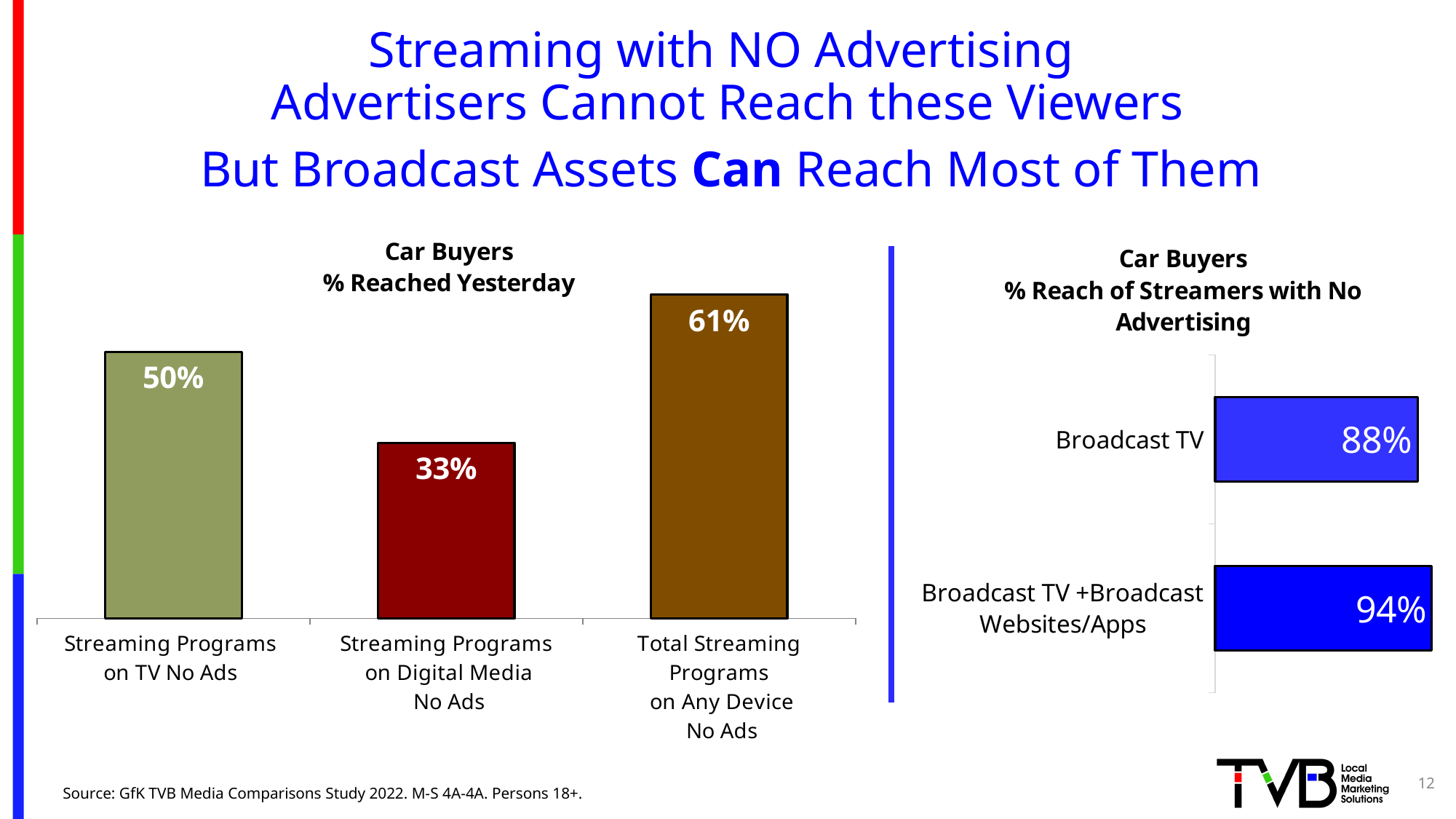
In the 'Car Buyers % Reach of Streamers with No Advertising' chart, which is larger: Broadcast TV or Broadcast TV + Broadcast Websites/Apps? Broadcast TV + Broadcast Websites/Apps In the 'Car Buyers % Reach of Streamers with No Advertising' chart, what is the difference between Broadcast TV + Broadcast Websites/Apps and Broadcast TV? 6% In the 'Car Buyers % Reached Yesterday' chart, how many categories are shown? 3 What kind of chart is the 'Car Buyers % Reach of Streamers with No Advertising' chart on the right? Bar chart In the 'Car Buyers % Reached Yesterday' chart, what is the difference between Total Streaming Programs on Any Device No Ads and Streaming Programs on TV No Ads? 11% In the 'Car Buyers % Reached Yesterday' chart, which category has the highest value? Total Streaming Programs on Any Device No Ads In the 'Car Buyers % Reach of Streamers with No Advertising' chart, what is the value for Broadcast TV? 88% In the 'Car Buyers % Reached Yesterday' chart, what is the value for Streaming Programs on Digital Media No Ads? 33% In the 'Car Buyers % Reach of Streamers with No Advertising' chart, what is the value for Broadcast TV + Broadcast Websites/Apps? 94% In the 'Car Buyers % Reached Yesterday' chart, which category has the lowest value? Streaming Programs on Digital Media No Ads In the 'Car Buyers % Reached Yesterday' chart, what colour is the bar for Streaming Programs on Digital Media No Ads? Dark red In the 'Car Buyers % Reached Yesterday' chart, what is the value for Streaming Programs on TV No Ads? 50%